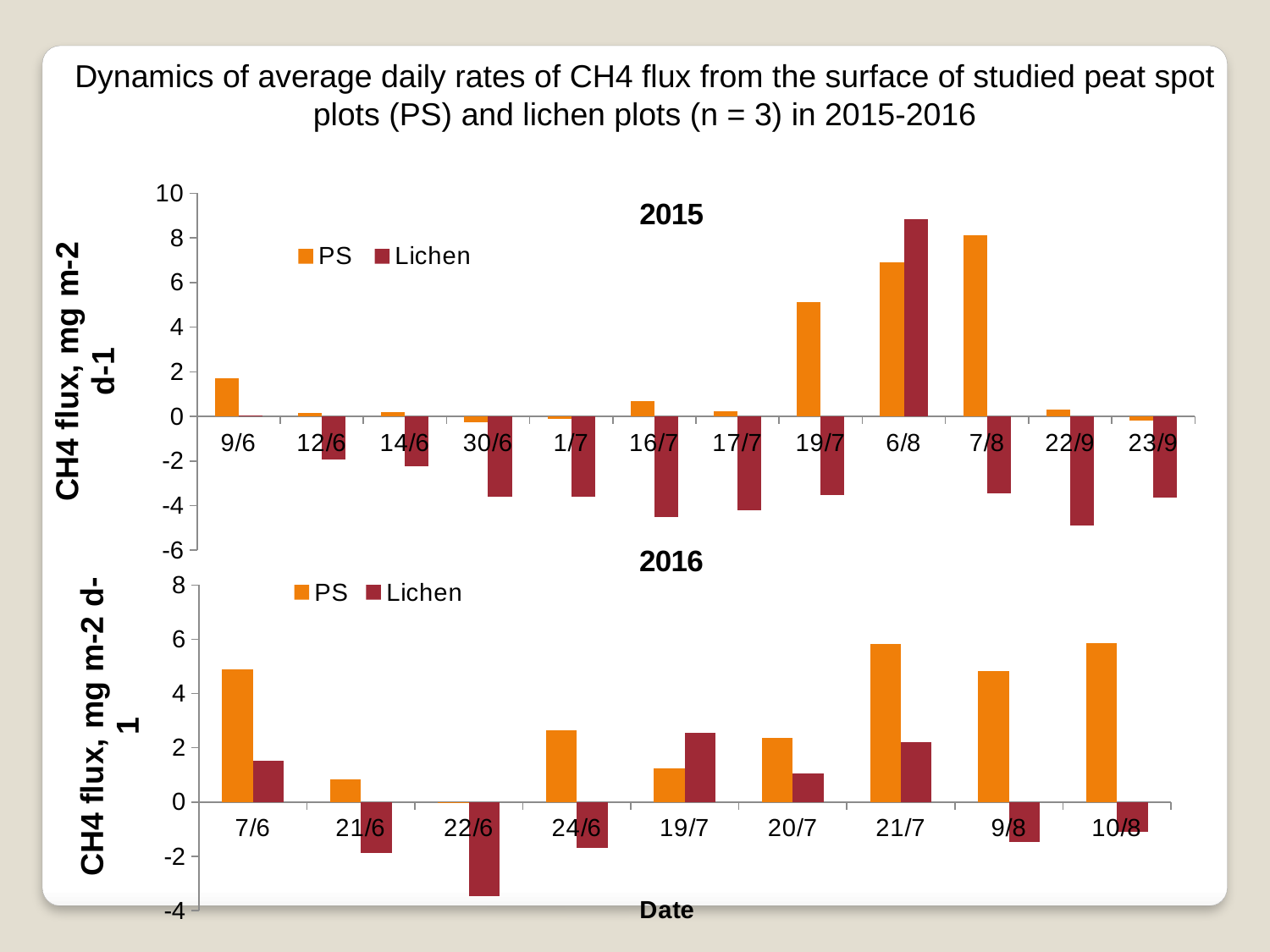
In the 2016 chart, on which date is the Lichen value lowest? 22/6 In the 2015 chart, which series has the larger value on 6/8, PS or Lichen? Lichen In the 2015 chart, is the Lichen value for 6/8 greater or less than 8? greater In the 2015 chart, is the PS value for 19/7 greater or less than 4? greater In the 2016 chart, how many dates are shown on the x axis? 9 In the 2015 chart, how many dates are shown on the x axis? 12 In the 2016 chart, how many series does the legend list? 2 In the 2015 chart, what type of chart is shown? bar chart In the 2015 chart, on which date is the Lichen value highest? 6/8 In the 2016 chart, is the Lichen value for 22/6 greater or less than -2? less In the 2015 chart, on which date is the PS value highest? 7/8 In the 2016 chart, which series has the larger value on 7/6, PS or Lichen? PS